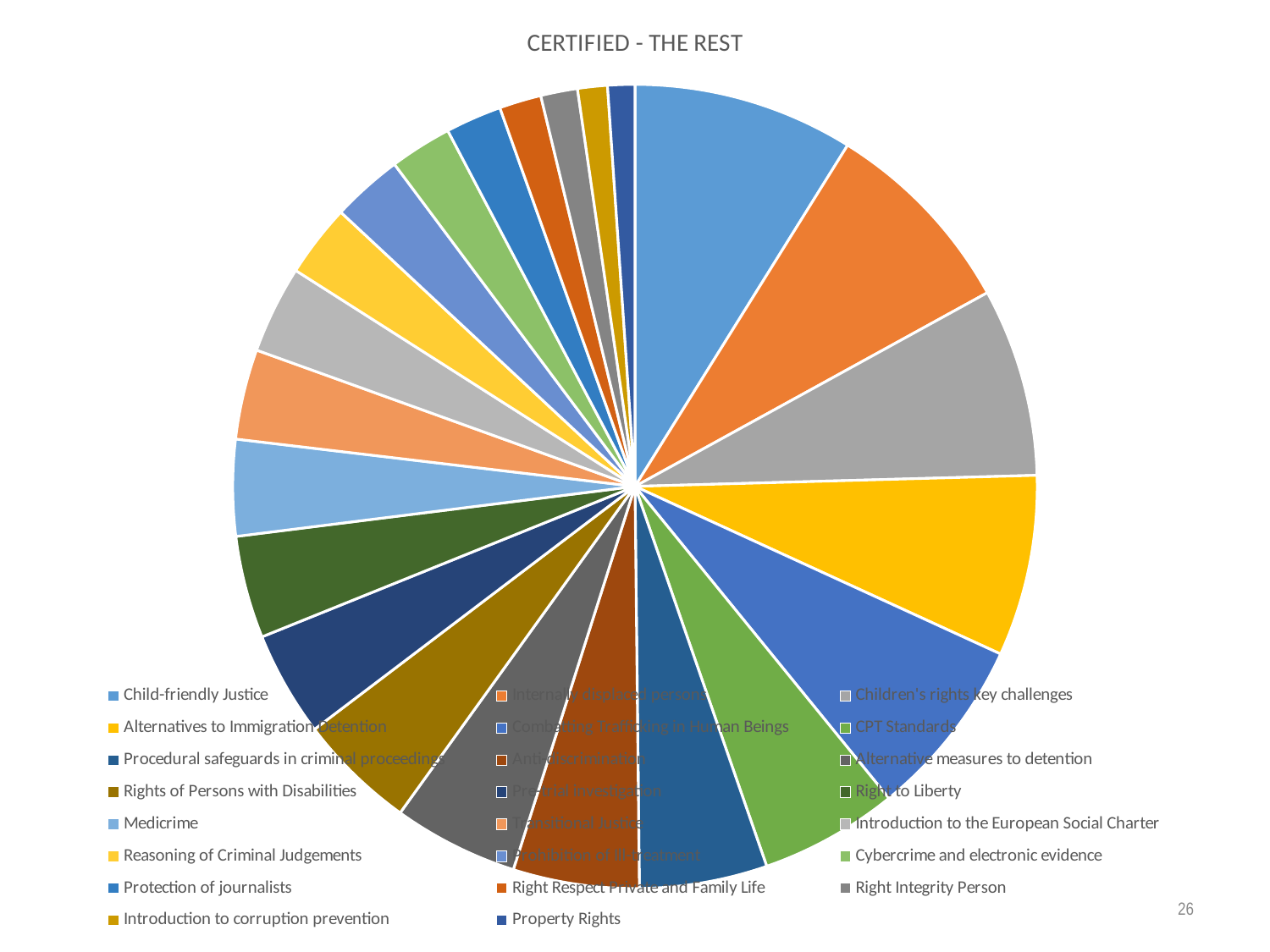
Which slice is larger, Internally displaced persons or Protection of journalists? Internally displaced persons How many entries does the legend list? 23 Which slice is larger, Alternatives to Immigration Detention or Property Rights? Alternatives to Immigration Detention Which slice is larger, Child-friendly Justice or Medicrime? Child-friendly Justice What kind of chart is shown on the slide? Pie chart Where is the legend positioned relative to the pie? Below the pie Which category has the largest slice of the pie? Child-friendly Justice What is the title of the chart? CERTIFIED - THE REST How many slices does the pie chart have? 23